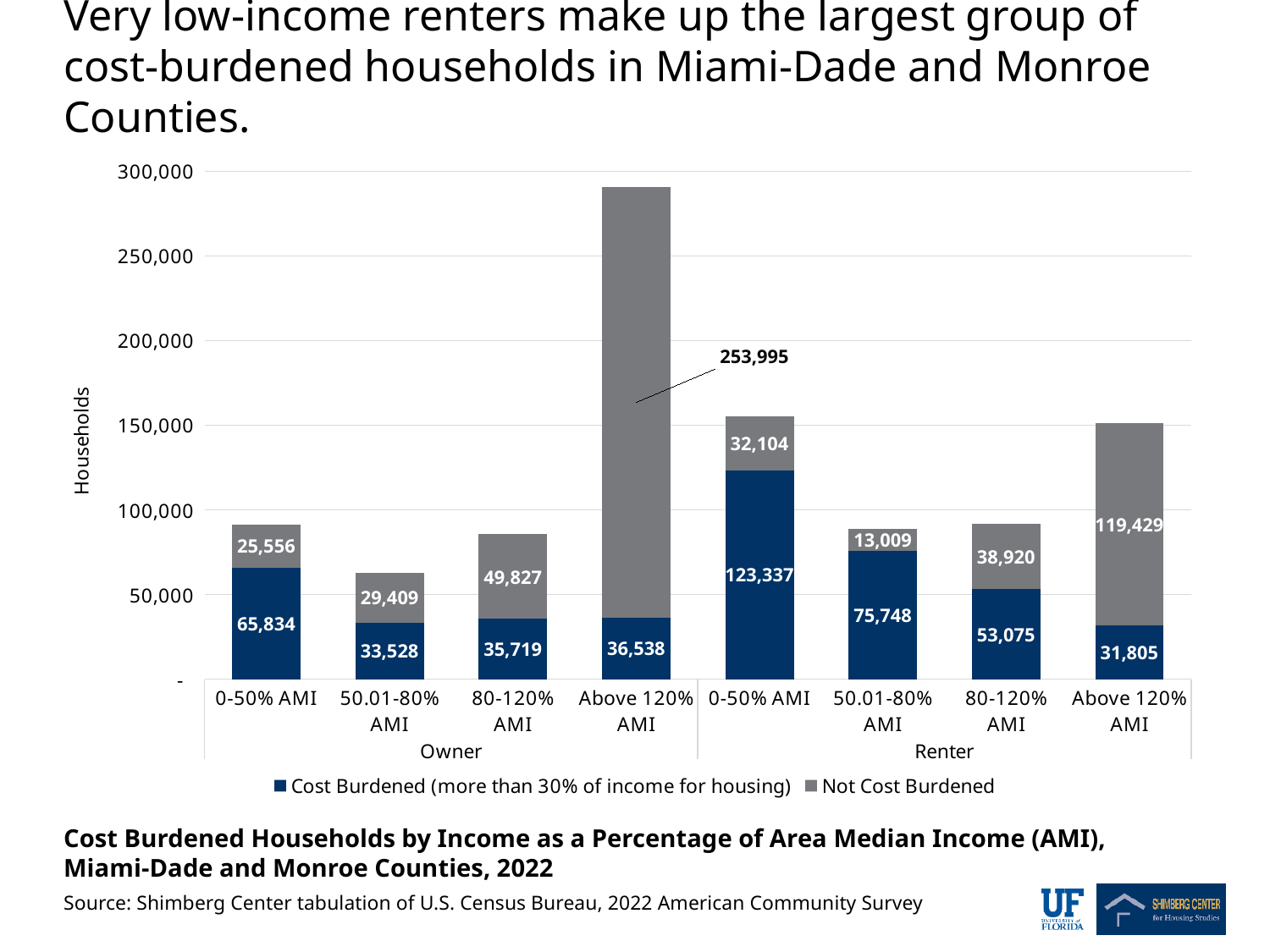
How many series does the legend list? 2 What is the Not Cost Burdened value for owners with income Above 120% AMI? 253,995 How many bars (income group and tenure combinations) are shown in the chart? 8 Which has more Not Cost Burdened households: owners at 80-120% AMI or renters at 80-120% AMI? Owners at 80-120% AMI Which income group and tenure has the highest number of Cost Burdened households? Renter, 0-50% AMI How many Cost Burdened households are there among renters with 0-50% AMI? 123,337 What is the total number of households for renters with income Above 120% AMI? 151,234 Which income group and tenure has the lowest number of Not Cost Burdened households? Renter, 50.01-80% AMI What type of chart is shown on the slide? Stacked bar chart What is the total number of households (Cost Burdened plus Not Cost Burdened) for owners with 0-50% AMI? 91,390 Is the total height of the bar for owners Above 120% AMI greater or less than 250,000? greater How many more Cost Burdened households are there among 0-50% AMI renters than among 0-50% AMI owners? 57,503